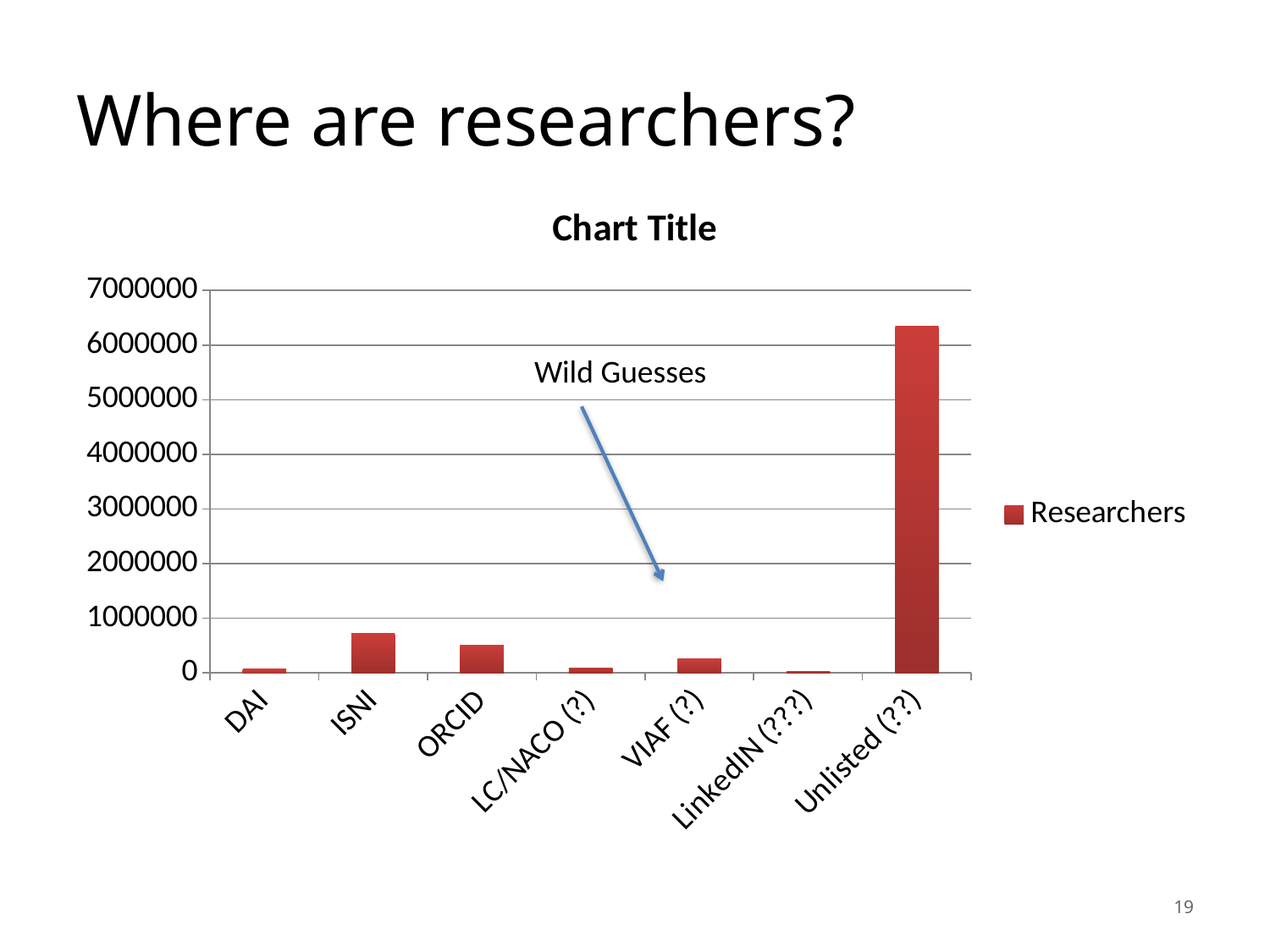
What text does the arrow annotation on the chart say? Wild Guesses Is the value for ISNI greater or less than 1000000? less Is the value for ORCID greater or less than 1000000? less What series name is shown in the chart's legend? Researchers Which category has the highest value in the chart? Unlisted (??) Which is larger, the value for VIAF (?) or the value for Unlisted (??)? Unlisted (??) Which is larger, the value for ISNI or the value for ORCID? ISNI How many categories are shown on the x axis of the chart? 7 Is the value for Unlisted (??) greater or less than 6000000? greater How many series does the chart's legend list? 1 What kind of chart is shown on the slide? bar chart